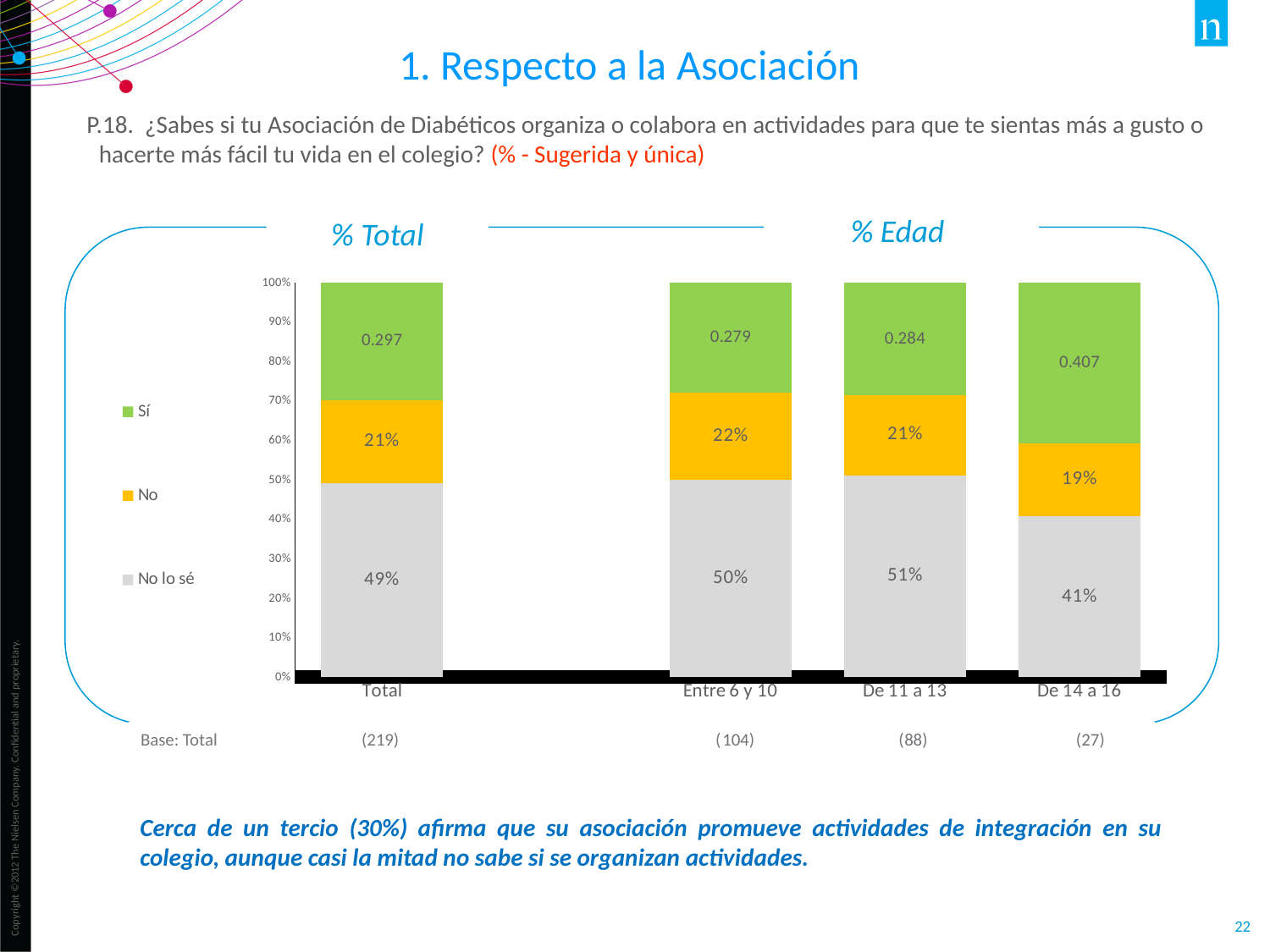
How many series does the legend list? 3 What is the value of the "No" segment for the "Entre 6 y 10" bar? 22% Which category has the lowest "No lo sé" value? De 14 a 16 Which category has the lowest "No" value? De 14 a 16 What kind of chart is shown on the slide? Stacked bar chart How many categories (bars) are shown on the x axis? 4 What is the difference between the "No lo sé" value for Total and for "De 14 a 16"? 8% What is the value of the "Sí" segment for the "De 14 a 16" bar? 0.407 What is the value of the "Sí" segment for the Total bar? 0.297 What is the value of the "No lo sé" segment for the Total bar? 49% Which category has the highest "Sí" value? De 14 a 16 Which is larger, the "Sí" value for "Entre 6 y 10" or for "De 11 a 13"? De 11 a 13